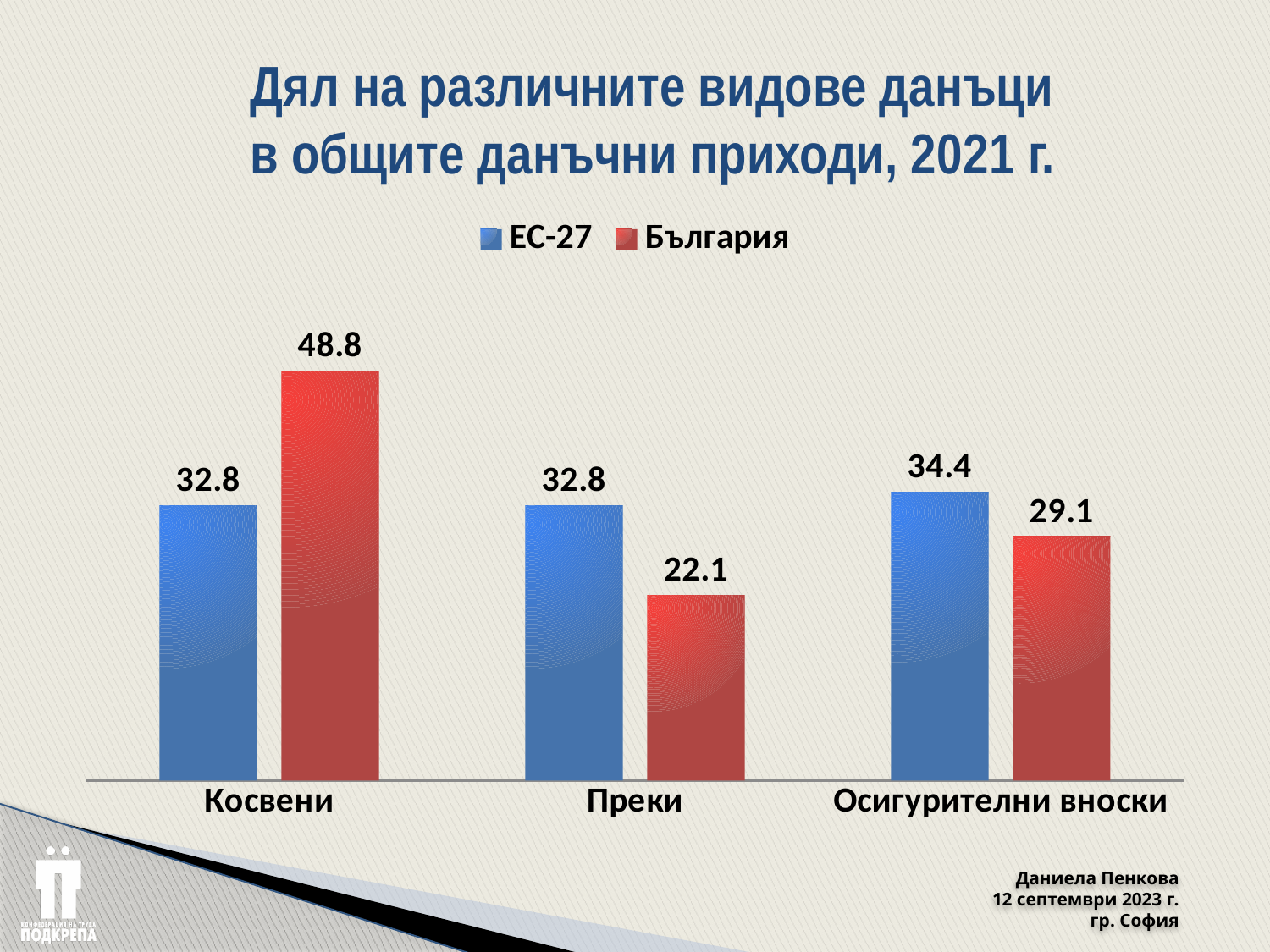
What is the value for България in the Косвени category? 48.8 What is the value for България in the Осигурителни вноски category? 29.1 What is the difference between the ЕС-27 and България values in the Преки category? 10.7 In the Осигурителни вноски category, which series has the larger value, ЕС-27 or България? ЕС-27 What is the difference between the България and ЕС-27 values in the Косвени category? 16.0 Which category has the lowest value for България? Преки Which category has the highest value for ЕС-27? Осигурителни вноски How many categories are shown on the x axis? 3 What is the value for ЕС-27 in the Преки category? 32.8 What is the value for ЕС-27 in the Осигурителни вноски category? 34.4 Which category has the highest value for България? Косвени How many series does the legend list? 2